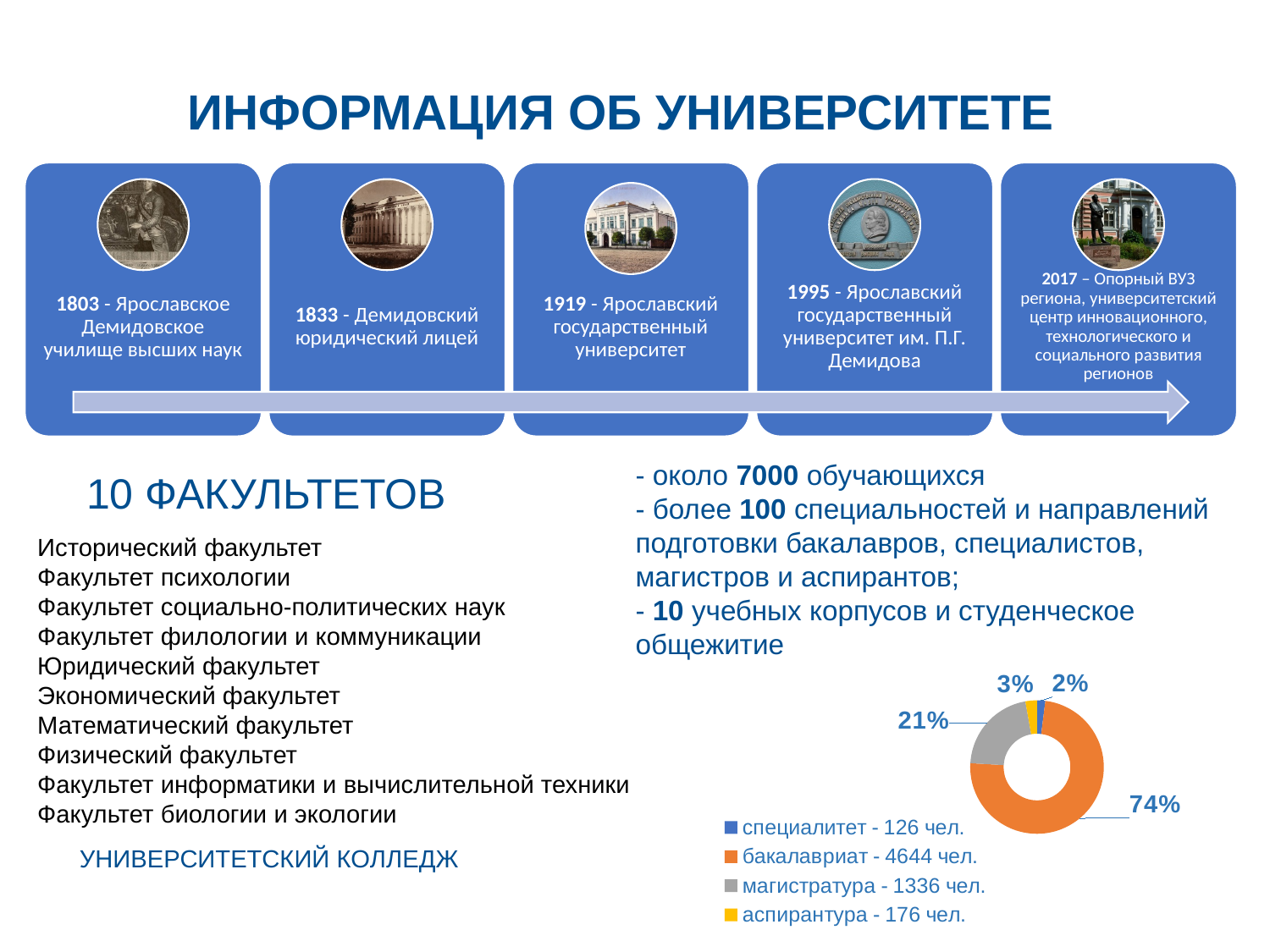
What percentage share does магистратура have in the doughnut chart? 21% How many people are in бакалавриат according to the chart legend? 4644 чел. What kind of chart is shown on the slide? doughnut (pie) chart What percentage share does аспирантура have in the doughnut chart? 3% Which category has the largest share in the doughnut chart? бакалавриат Which category has the smallest share in the doughnut chart? специалитет Which colour represents магистратура in the doughnut chart? gray How many categories does the legend of the doughnut chart list? 4 What is the difference in percentage points between бакалавриат and магистратура in the doughnut chart? 53% What percentage share does специалитет have in the doughnut chart? 2% How many people are in магистратура according to the chart legend? 1336 чел.